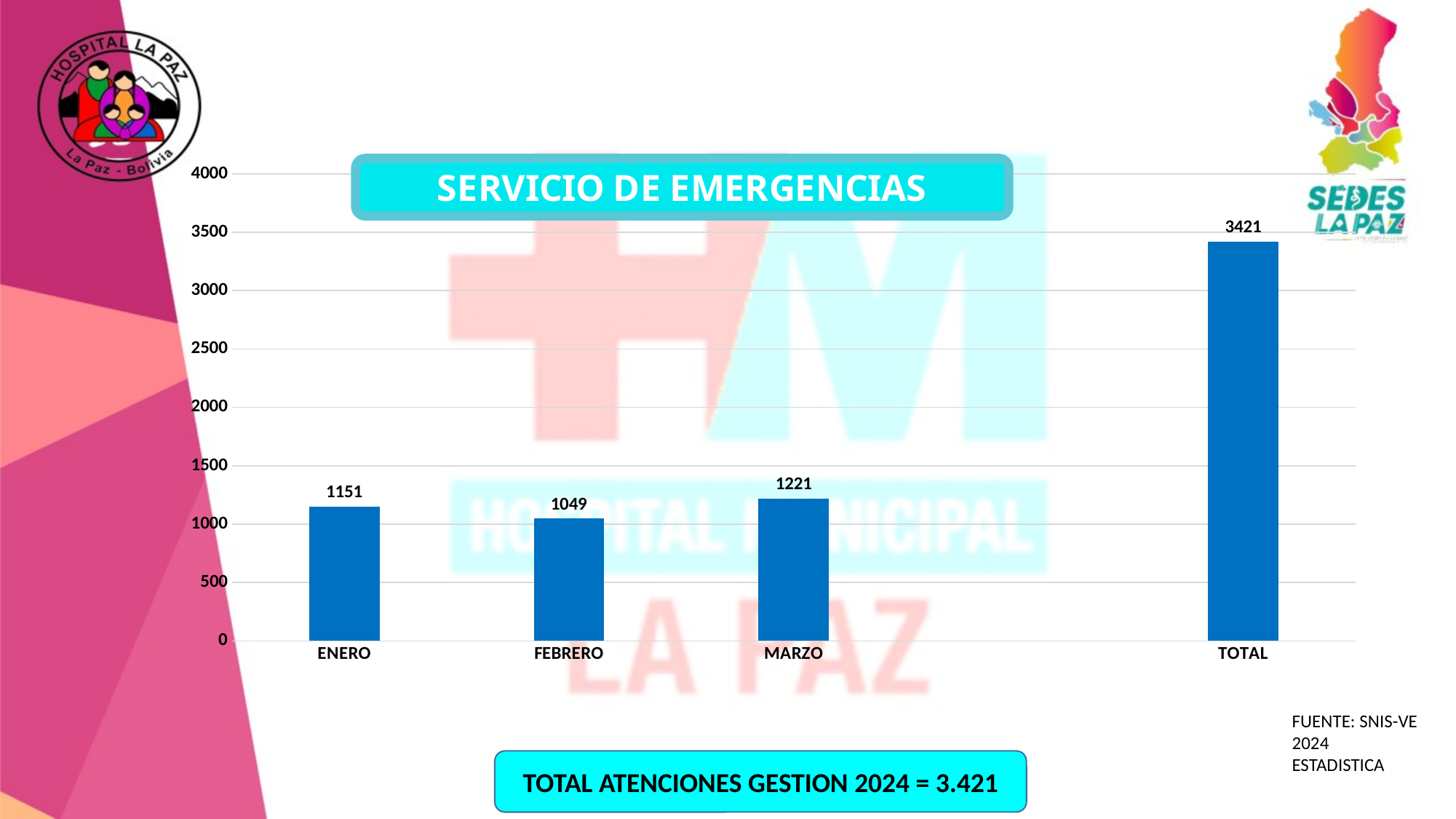
What is the value for FEBRERO? 1049 What is the value for TOTAL? 3421 Which category has the lowest value? FEBRERO What is the value for ENERO? 1151 Which of the three months (ENERO, FEBRERO, MARZO) has the highest value? MARZO Is the value for TOTAL greater or less than 3000? greater Which is larger, the value for ENERO or the value for MARZO? MARZO What is the value for MARZO? 1221 What is the title of the chart? SERVICIO DE EMERGENCIAS What is the difference between the values for MARZO and FEBRERO? 172 How many bars are shown in the chart? 4 What is the difference between the values for ENERO and FEBRERO? 102